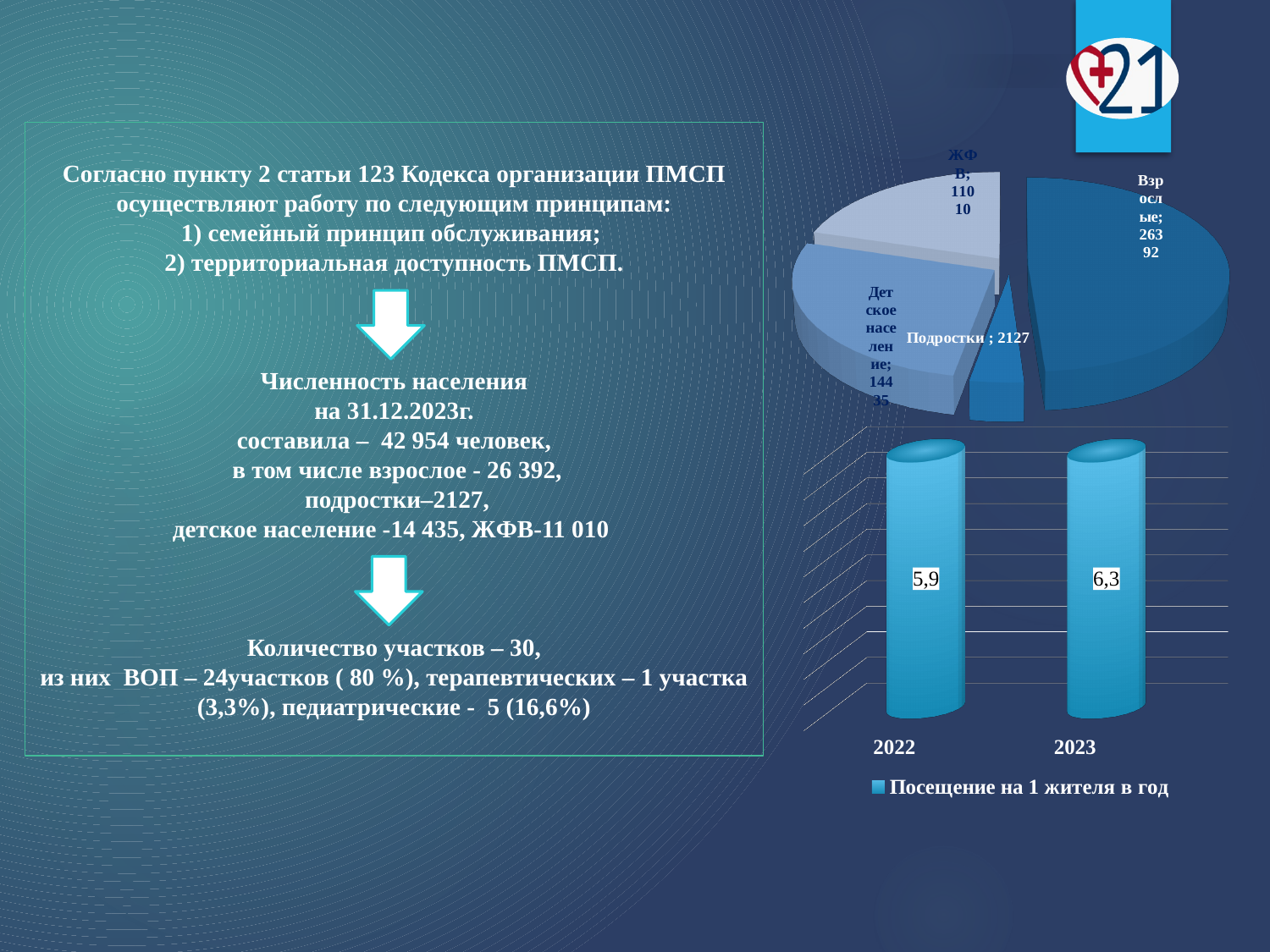
In the bar chart at the bottom right, how many bars are plotted? 2 In the bar chart at the bottom right, what is the value for 2023? 6,3 In the bar chart at the bottom right, what is the value for 2022? 5,9 What kind of chart is shown at the top right of the slide? pie chart In the pie chart at the top right, which category has the largest slice? Взрослые In the bar chart at the bottom right, which year has the higher value, 2022 or 2023? 2023 In the bar chart at the bottom right, what series name does the legend show? Посещение на 1 жителя в год In the pie chart at the top right, which category has the smallest slice? Подростки In the bar chart at the bottom right, what is the difference between the 2023 and 2022 values? 0,4 In the bar chart at the bottom right, do the values rise or fall from 2022 to 2023? rise In the pie chart at the top right, what is the value for Подростки? 2127 In the pie chart at the top right, how many slices are there? 4